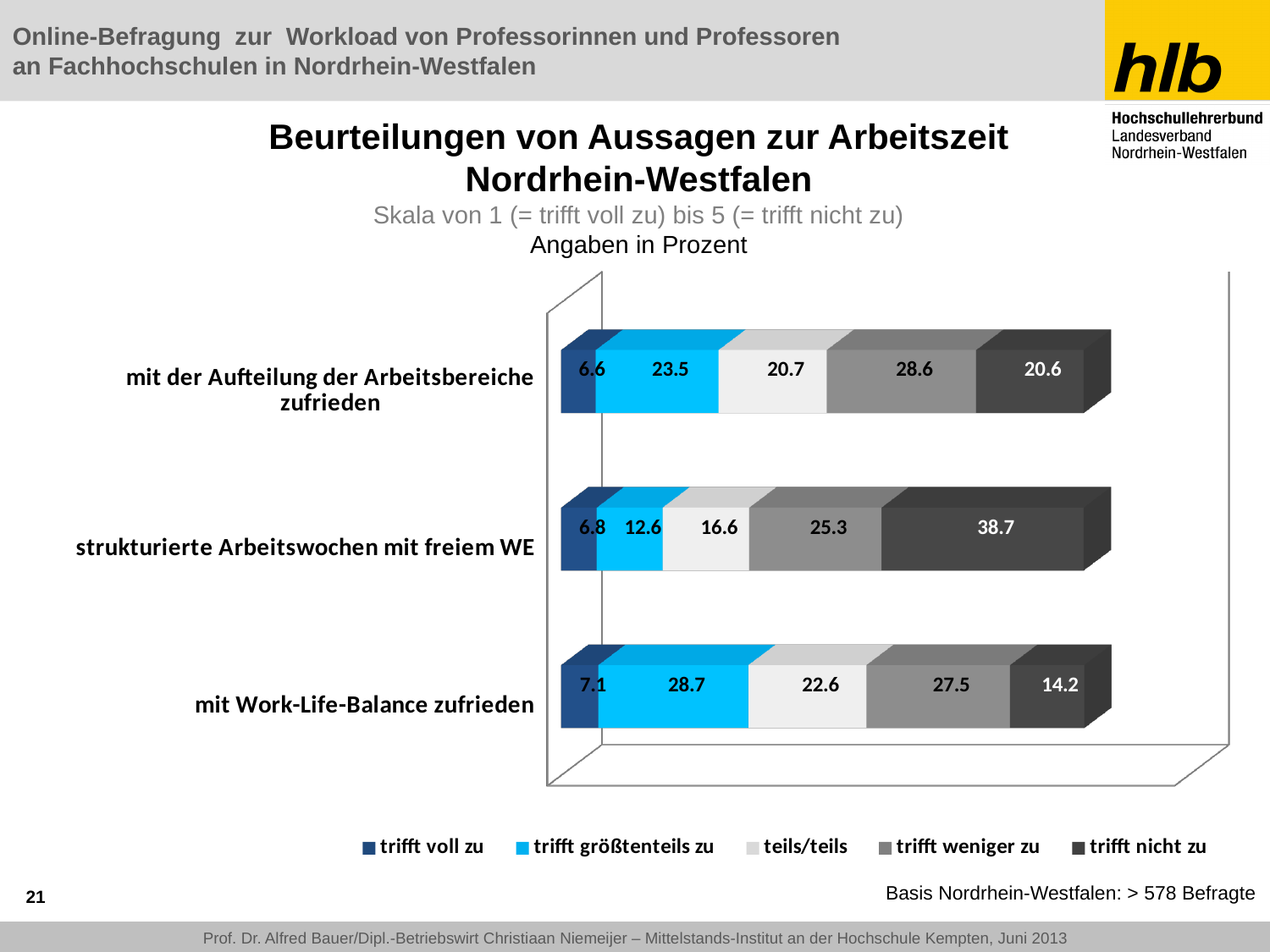
What is the title of the chart? Beurteilungen von Aussagen zur Arbeitszeit Nordrhein-Westfalen Which statement has the lowest value for "trifft voll zu"? mit der Aufteilung der Arbeitsbereiche zufrieden What is the value for "trifft nicht zu" for "strukturierte Arbeitswochen mit freiem WE"? 38.7 How many statements (categories) are shown in the chart? 3 What is the value for "trifft größtenteils zu" for "mit Work-Life-Balance zufrieden"? 28.7 What is the difference between the "trifft nicht zu" values for "strukturierte Arbeitswochen mit freiem WE" and "mit Work-Life-Balance zufrieden"? 24.5 How many series does the legend list? 5 Which is larger: the "trifft weniger zu" value for "mit der Aufteilung der Arbeitsbereiche zufrieden" or for "mit Work-Life-Balance zufrieden"? mit der Aufteilung der Arbeitsbereiche zufrieden What is the total of the stacked bar for "strukturierte Arbeitswochen mit freiem WE"? 100.0 What kind of chart is shown on the slide? stacked bar chart Which statement has the highest value for "trifft nicht zu"? strukturierte Arbeitswochen mit freiem WE What is the value for "teils/teils" for "mit der Aufteilung der Arbeitsbereiche zufrieden"? 20.7